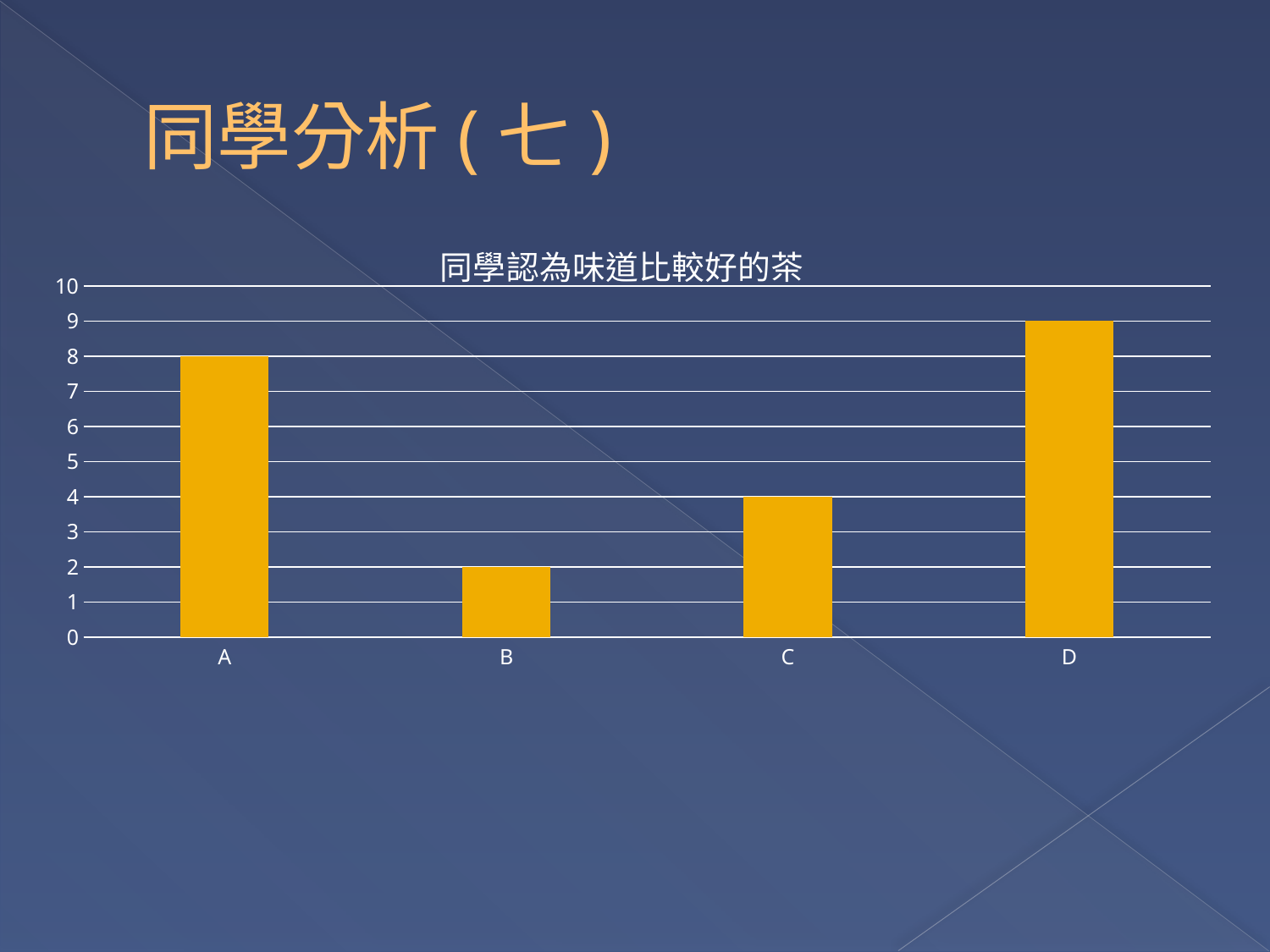
What is the title of the chart? 同學認為味道比較好的茶 What is the difference between the values for C and B? 2 Which category has the highest value? D Which category has the lowest value? B What kind of chart is this? Bar chart What is the difference between the values for D and A? 1 How many categories are shown on the x axis? 4 What is the value for A? 8 Which is larger, the value for A or the value for C? A What is the value for C? 4 What is the value for B? 2 What is the value for D? 9